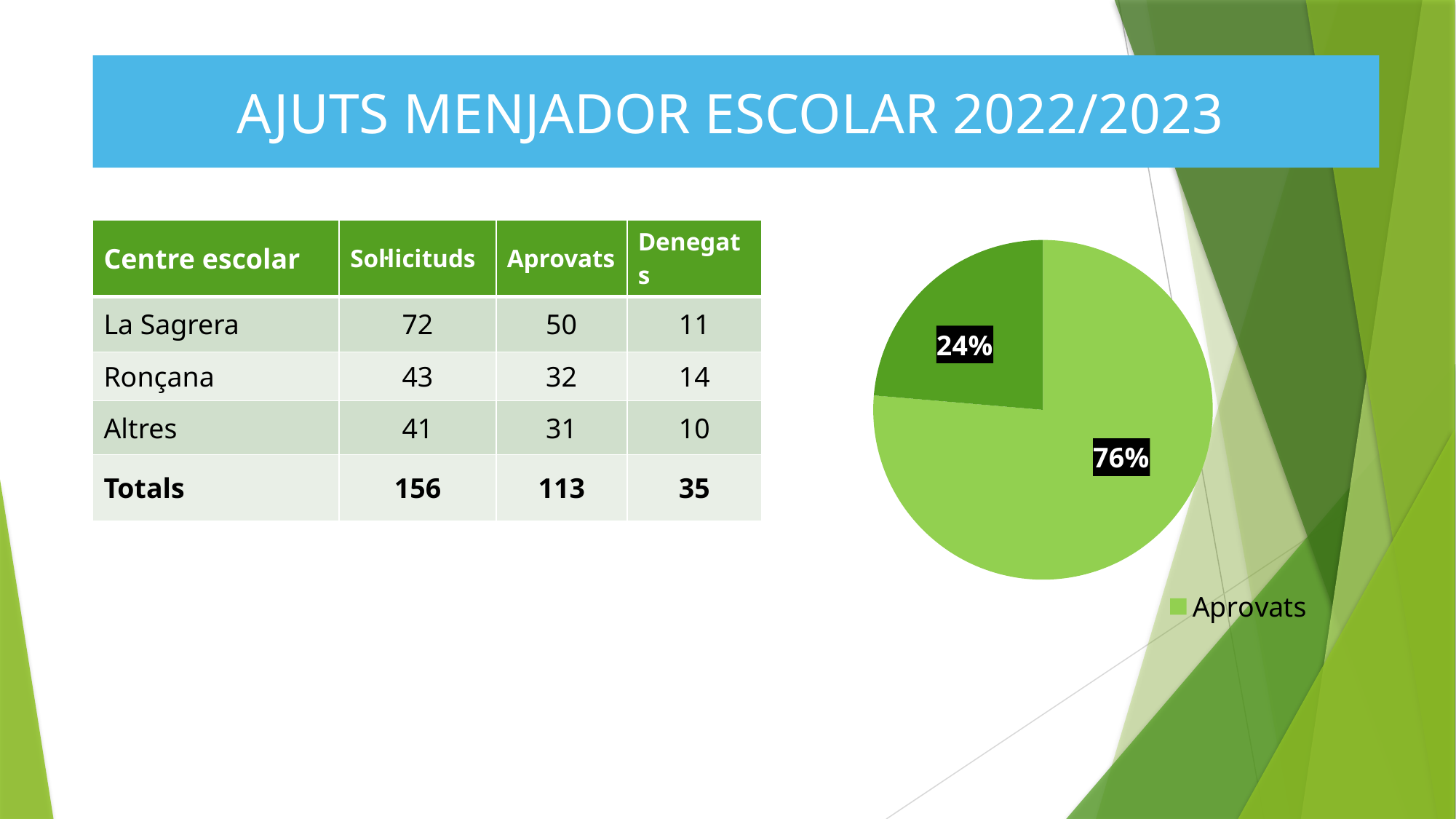
How many slices does the pie chart have? 2 What share of the pie chart does the Aprovats slice represent? 76% Which slice of the pie chart is the largest? Aprovats Which entry is listed in the pie chart's legend? Aprovats What is the largest percentage shown on the pie chart? 76% By how many percentage points does the larger slice of the pie chart exceed the smaller slice? 52 What percentage is shown on the smaller slice of the pie chart? 24% Is the share of the Aprovats slice greater or less than 50%? greater Is the Aprovats slice of the pie chart larger or smaller than the other slice? larger What is the smallest percentage shown on the pie chart? 24% What kind of chart is shown on the slide? pie chart What colour is the Aprovats slice of the pie chart? light green